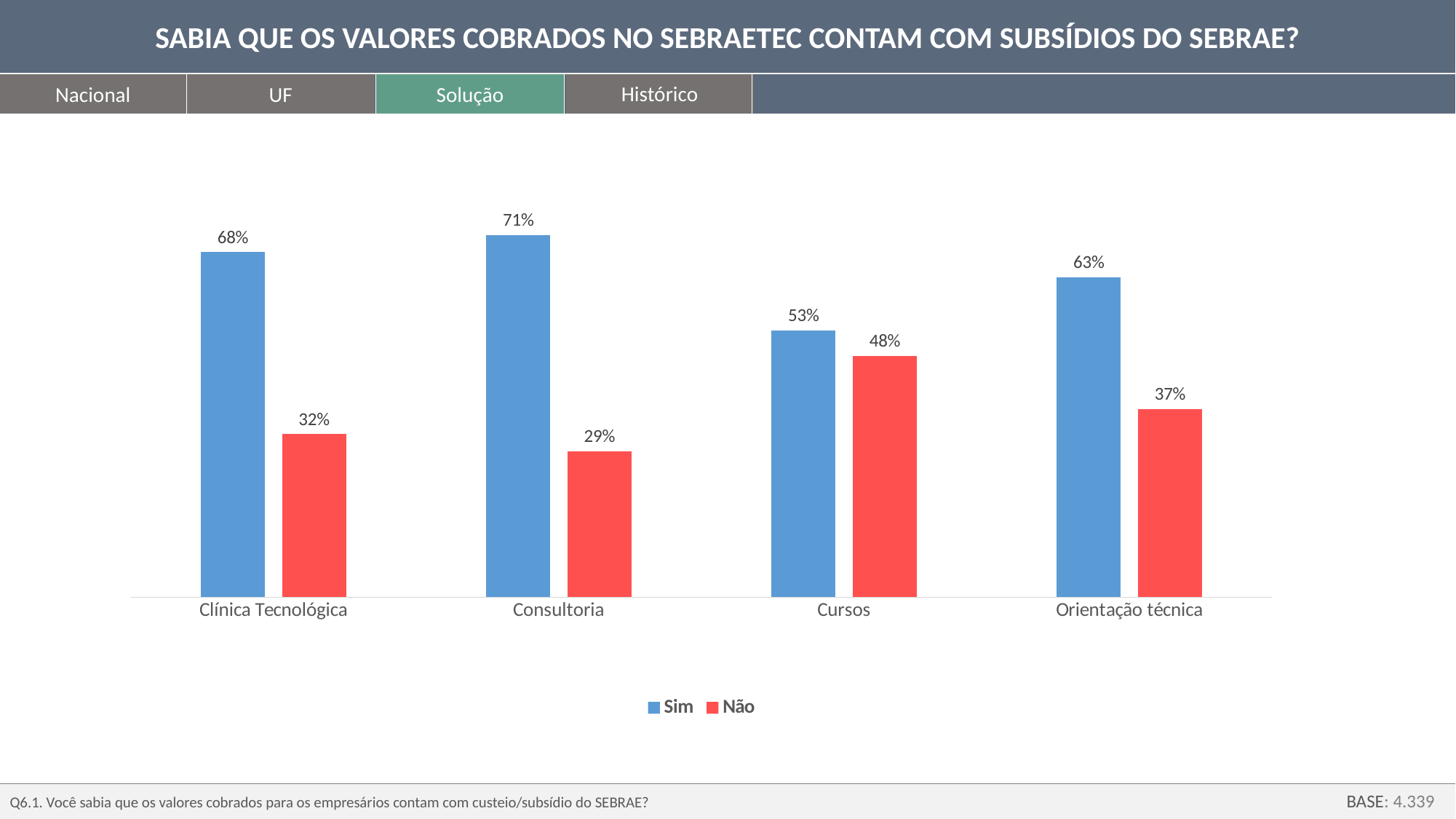
How many categories are shown on the x axis? 4 How many series does the legend list? 2 Which is larger: the 'Sim' value for Clínica Tecnológica or the 'Sim' value for Orientação técnica? Clínica Tecnológica What is the difference between the 'Sim' and 'Não' values for Cursos? 5% What is the 'Sim' value for Orientação técnica? 63% Which category has the highest 'Sim' value? Consultoria What is the 'Não' value for Cursos? 48% Which category has the lowest 'Não' value? Consultoria What is the 'Sim' value for Consultoria? 71% Which colour represents the 'Não' series in the legend? Red What kind of chart is shown on the slide? Bar chart What is the 'Não' value for Clínica Tecnológica? 32%